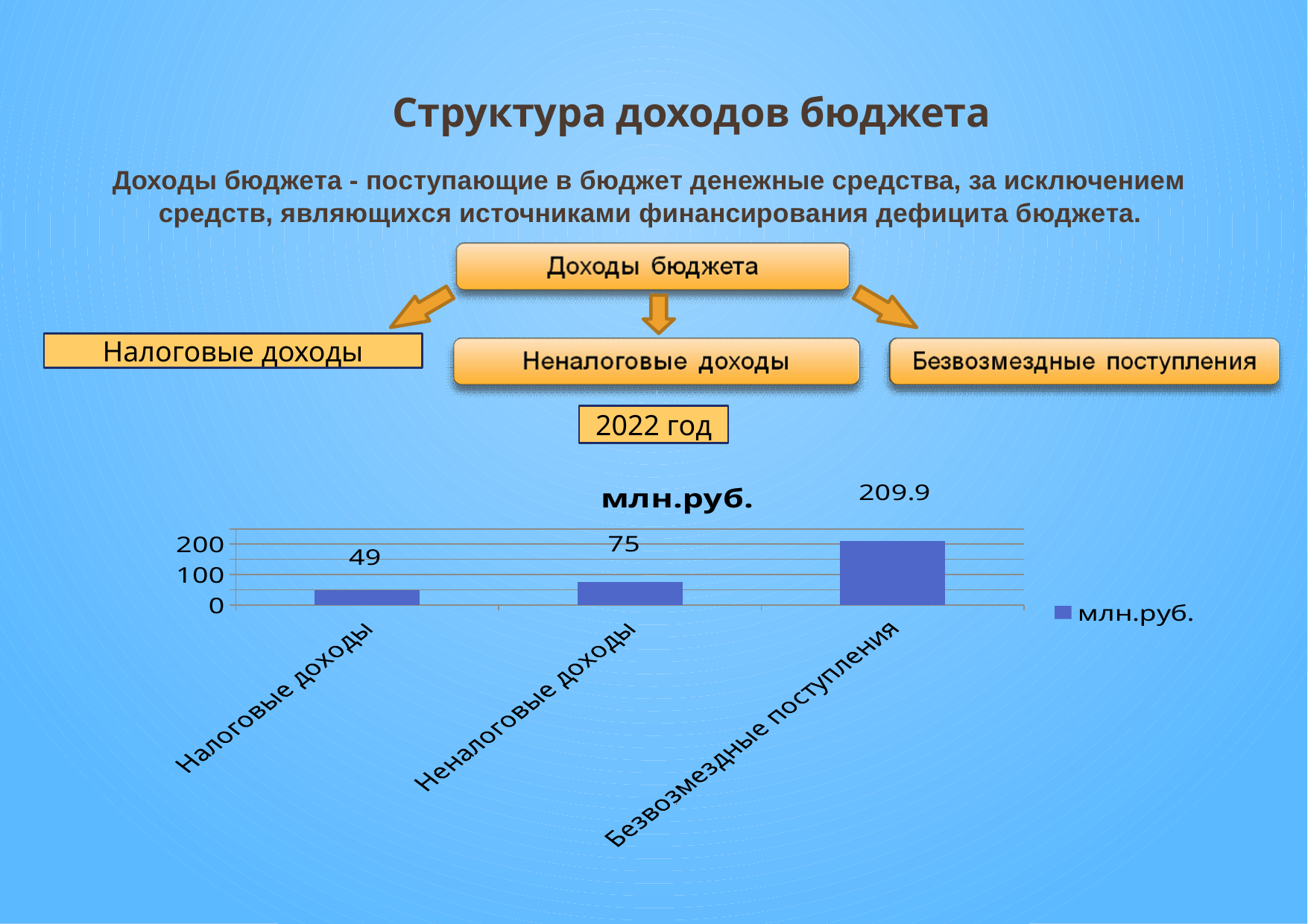
What is the difference between the values for Безвозмездные поступления and Неналоговые доходы? 134.9 What is the difference between the values for Неналоговые доходы and Налоговые доходы? 26 What is the value for Безвозмездные поступления in the chart? 209.9 What is the value for Неналоговые доходы in the chart? 75 How many categories are shown in the chart? 3 What kind of chart is shown on the slide? bar chart Which is larger: the value for Налоговые доходы or the value for Неналоговые доходы? Неналоговые доходы Which category has the lowest value in the chart? Налоговые доходы Which category has the highest value in the chart? Безвозмездные поступления What is the value for Налоговые доходы in the chart? 49 What is the title of the chart? млн.руб. Is the value for Безвозмездные поступления greater or less than 200? greater